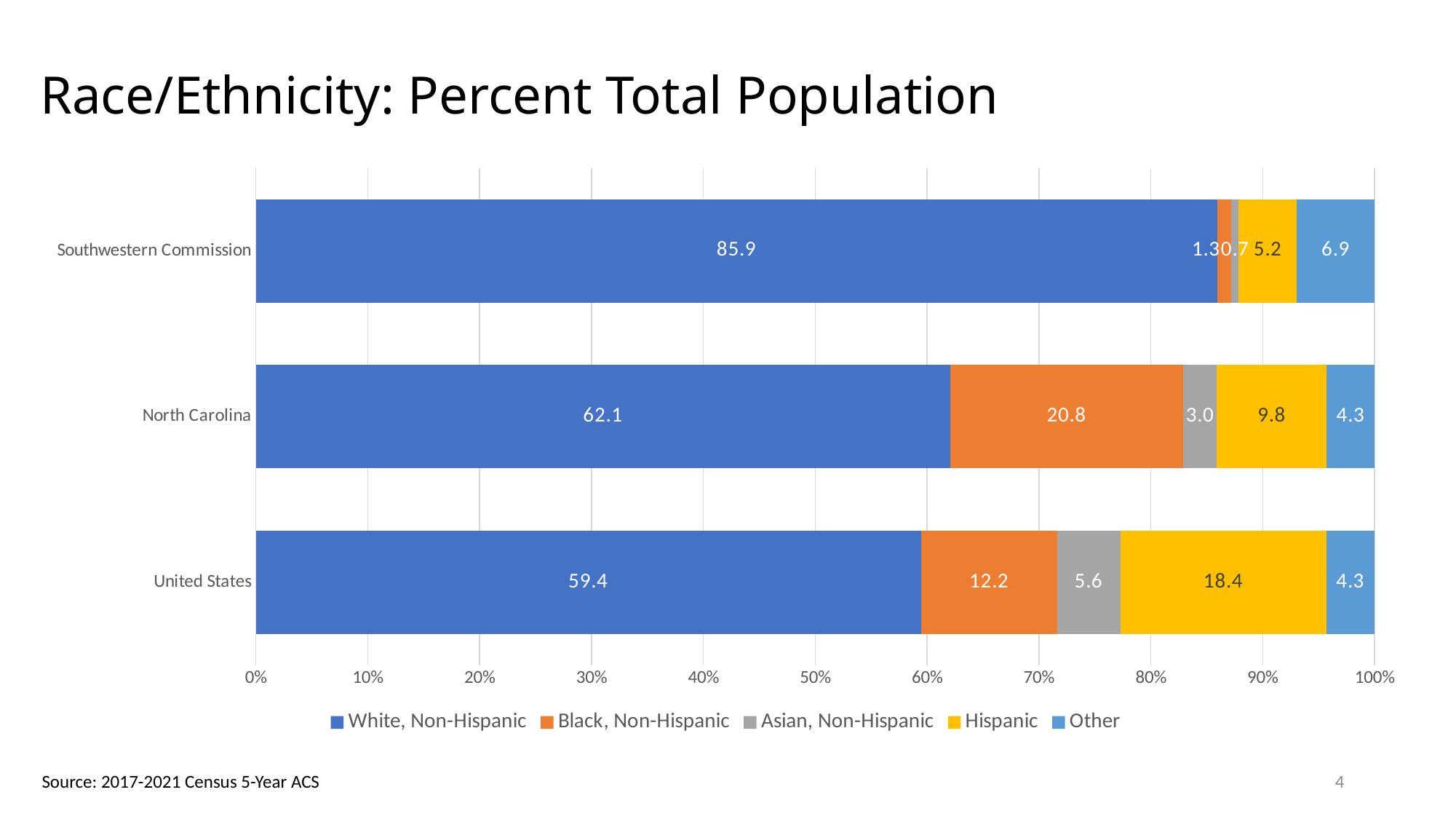
What is the difference between the Black, Non-Hispanic values for North Carolina and United States? 8.6 What is the difference between the White, Non-Hispanic values for North Carolina and United States? 2.7 What is the Black, Non-Hispanic value for North Carolina? 20.8 What is the Other value for Southwestern Commission? 6.9 Which category has the highest White, Non-Hispanic value? Southwestern Commission What is the Hispanic value for United States? 18.4 What kind of chart is shown on the slide? Stacked bar chart Which has the larger Asian, Non-Hispanic value, United States or North Carolina? United States Which category has the lowest Hispanic value? Southwestern Commission What is the White, Non-Hispanic value for Southwestern Commission? 85.9 How many categories are shown on the chart? 3 How many series does the legend list? 5